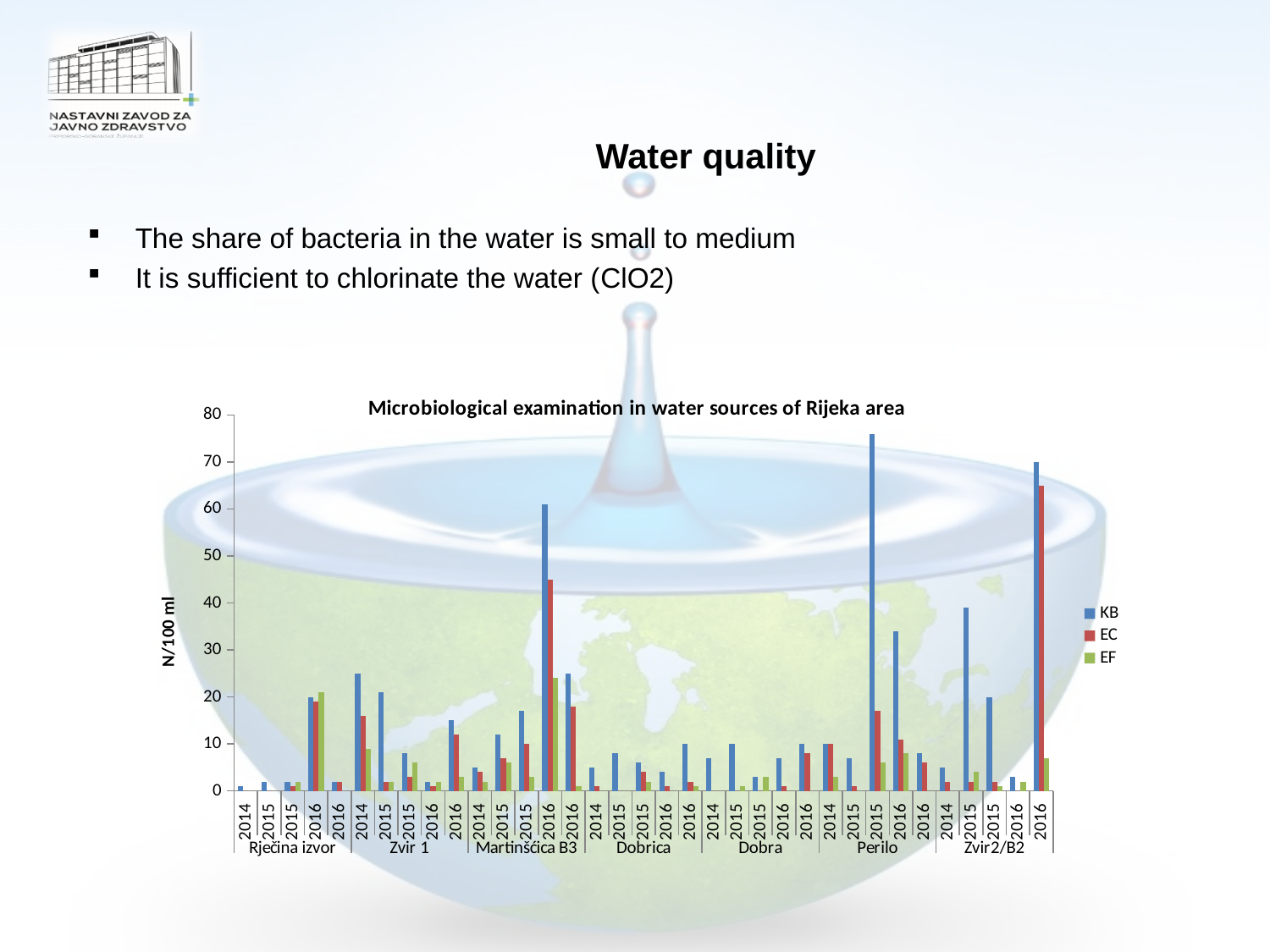
What are the three series named in the chart legend? KB, EC, EF How many series does the legend of the chart list? 3 How many water sources are shown as groups along the x axis of the chart? 7 Which series has the tallest bar anywhere in the chart? KB Is the EC value for Martinšćica B3 in 2016 greater or less than 50? less What is the title of the chart? Microbiological examination in water sources of Rijeka area Which water source and year has the highest KB value in the chart? Perilo 2015 What kind of chart is shown on the slide? bar chart